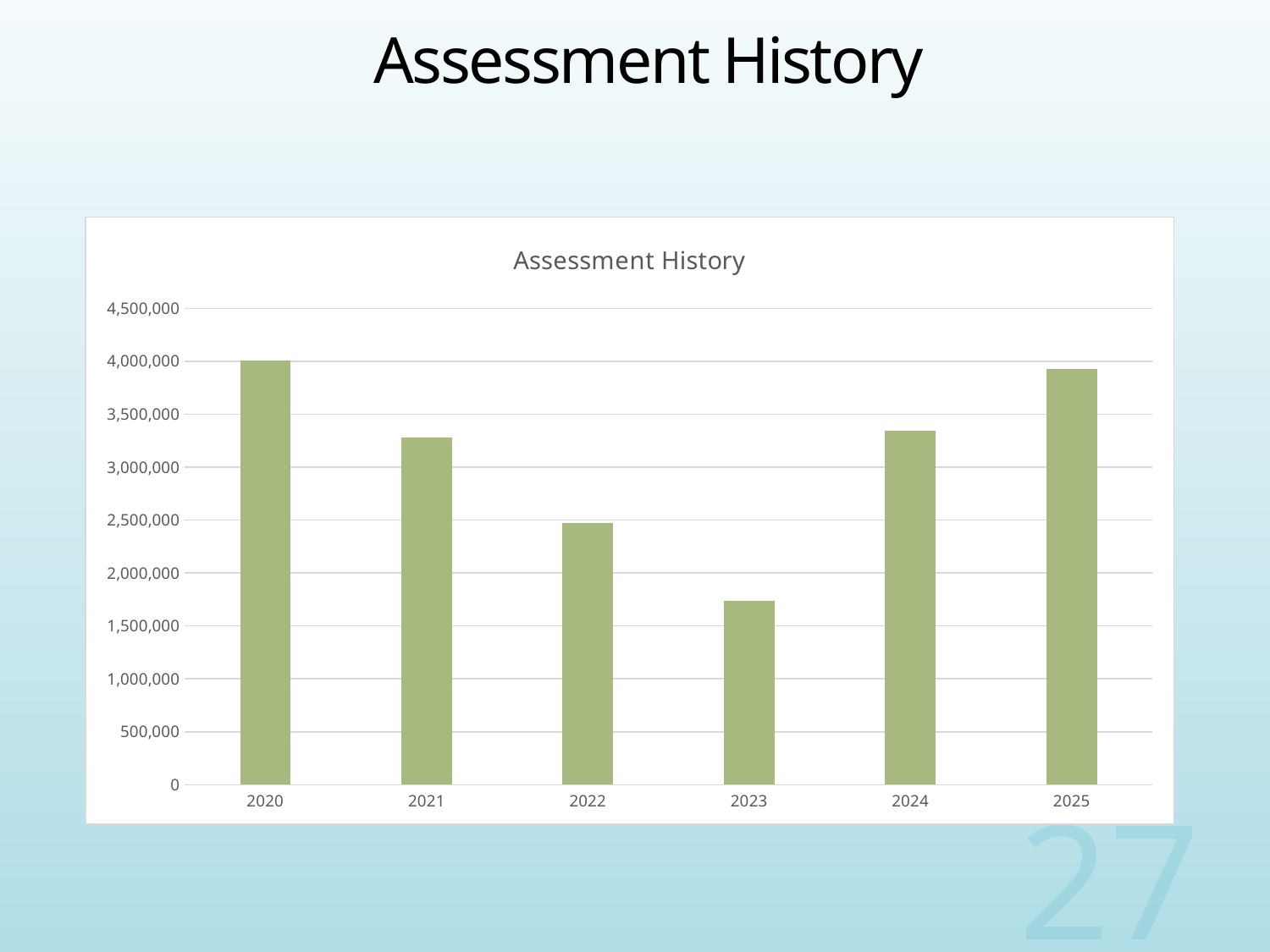
Which is larger, the value for 2022 or the value for 2023? 2022 Is the value for 2022 greater or less than 2,000,000? greater Which year has the lowest value in the chart? 2023 Is the value for 2025 greater or less than 3,500,000? greater Is the value for 2021 greater or less than 3,000,000? greater Which is larger, the value for 2024 or the value for 2025? 2025 What is the title of the chart? Assessment History What kind of chart is shown on the slide? bar chart How many years are shown on the x axis of the chart? 6 Do the values rise or fall from 2020 to 2023? fall